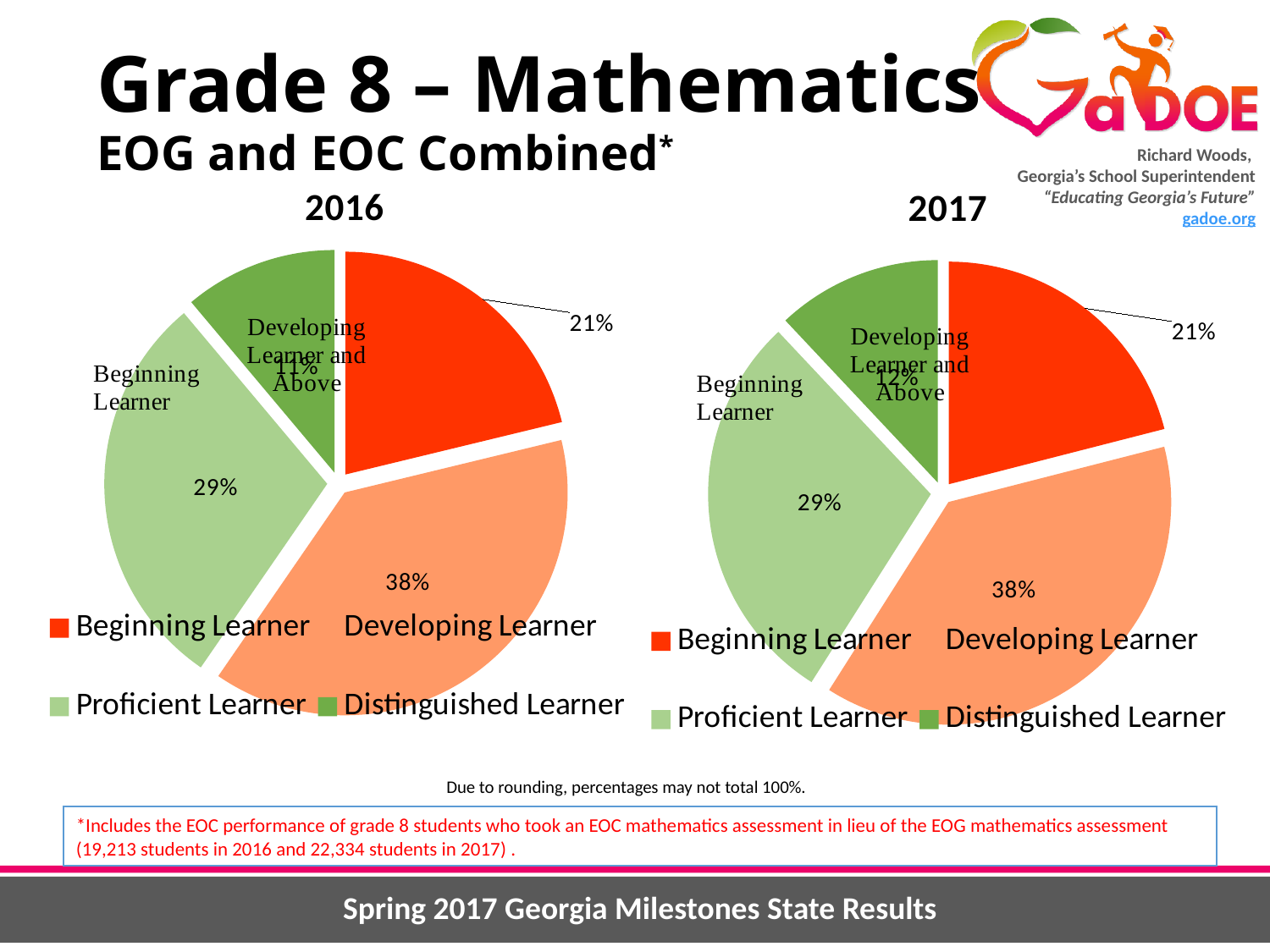
What is the title of the chart on the right side of the slide? 2017 What kind of chart is used to show the 2016 results? Pie chart How many slices does the 2016 pie chart have? 4 In the 2016 pie chart, which is larger: Proficient Learner or Beginning Learner? Proficient Learner In the 2017 pie chart, which category has the smallest share? Distinguished Learner In the 2017 pie chart, what is the difference between the Developing Learner and Proficient Learner percentages? 9% In the 2016 pie chart, what percentage is shown for Distinguished Learner? 11% How many entries does the legend of the 2017 chart list? 4 In the 2016 pie chart, which category has the largest share? Developing Learner In the 2017 pie chart, what percentage is shown for Distinguished Learner? 12% In the 2016 pie chart, what percentage is shown for Developing Learner? 38% In the 2017 pie chart, what percentage is shown for Beginning Learner? 21%